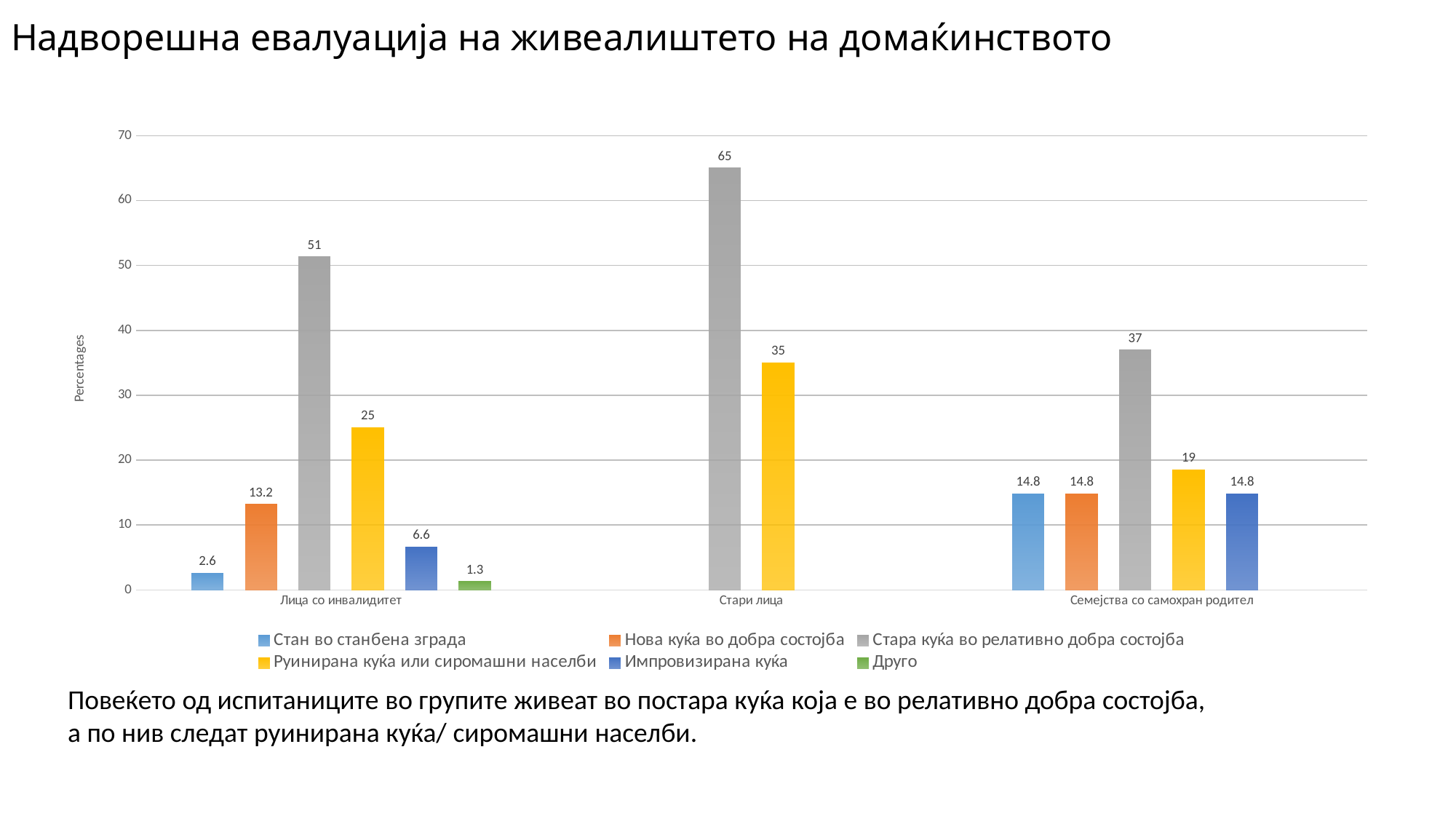
What is the label of the vertical axis? Percentages What is the value for "Стара куќа во релативно добра состојба" in the "Стари лица" category? 65 In the "Лица со инвалидитет" category, which is larger: "Нова куќа во добра состојба" or "Импровизирана куќа"? Нова куќа во добра состојба How many categories are shown on the x axis? 3 How many series does the legend list? 6 Which category has the highest value for "Стара куќа во релативно добра состојба"? Стари лица What is the value for "Импровизирана куќа" in the "Семејства со самохран родител" category? 14.8 Is the value for "Стара куќа во релативно добра состојба" in the "Семејства со самохран родител" category greater or less than 30? greater What kind of chart is shown on the slide? Bar chart What is the difference between the "Стара куќа во релативно добра состојба" value and the "Руинирана куќа или сиромашни населби" value in the "Стари лица" category? 30 Which series has the lowest value in the "Лица со инвалидитет" category? Друго What is the value for "Руинирана куќа или сиромашни населби" in the "Лица со инвалидитет" category? 25